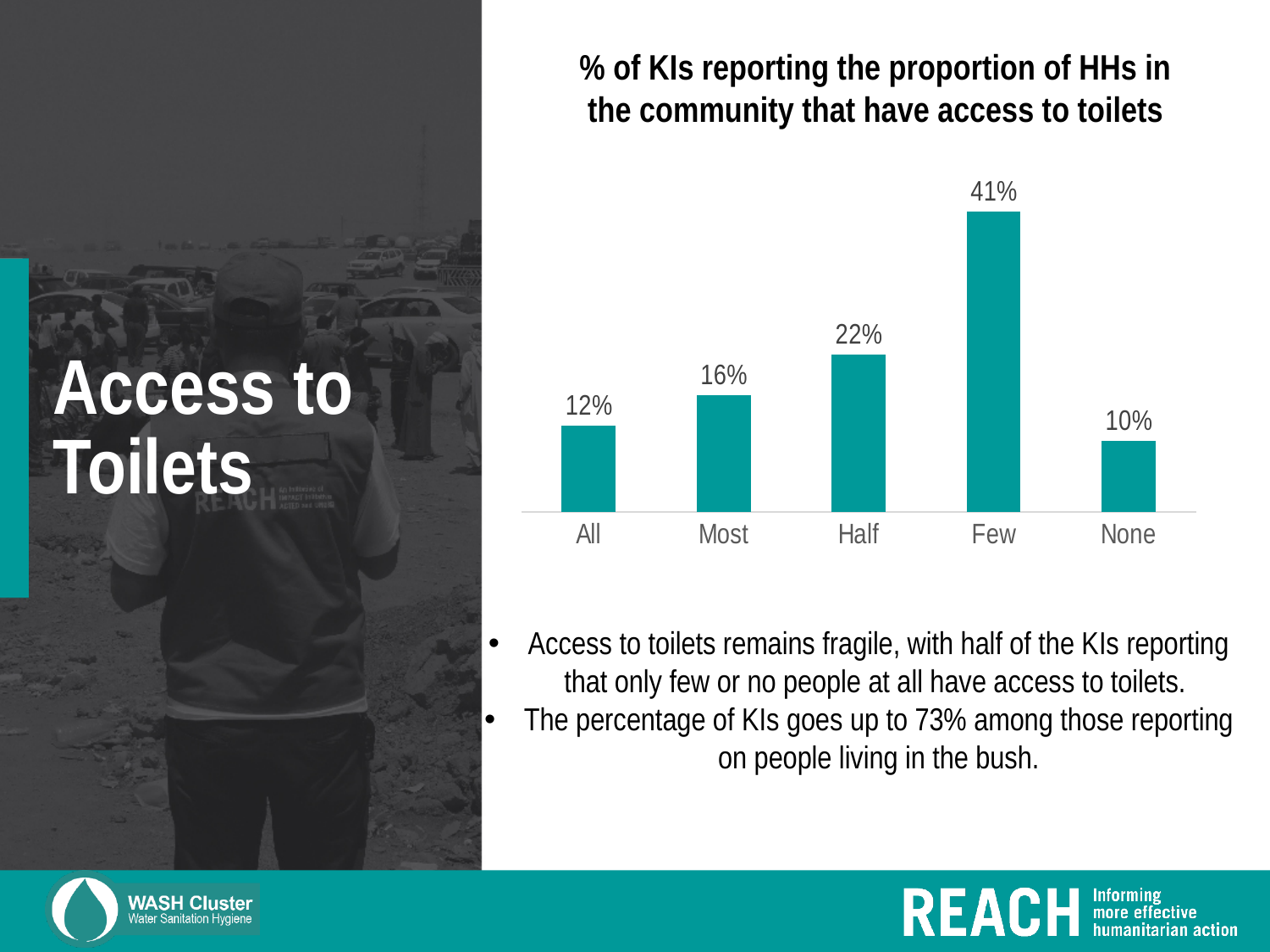
What percentage of KIs reported that 'Few' households have access to toilets? 41% Which category has the highest value? Few What is the value for the 'All' category? 12% What is the difference between the values for 'Most' and 'All'? 4% What is the title of the chart? % of KIs reporting the proportion of HHs in the community that have access to toilets What is the difference between the values for 'Few' and 'Half'? 19% Which category has the lowest value? None What is the value for the 'None' category? 10% What kind of chart is shown on the slide? Bar chart What is the combined value of the 'Few' and 'None' categories? 51% Which is larger, the value for 'Half' or the value for 'Most'? Half How many categories are shown on the x axis? 5